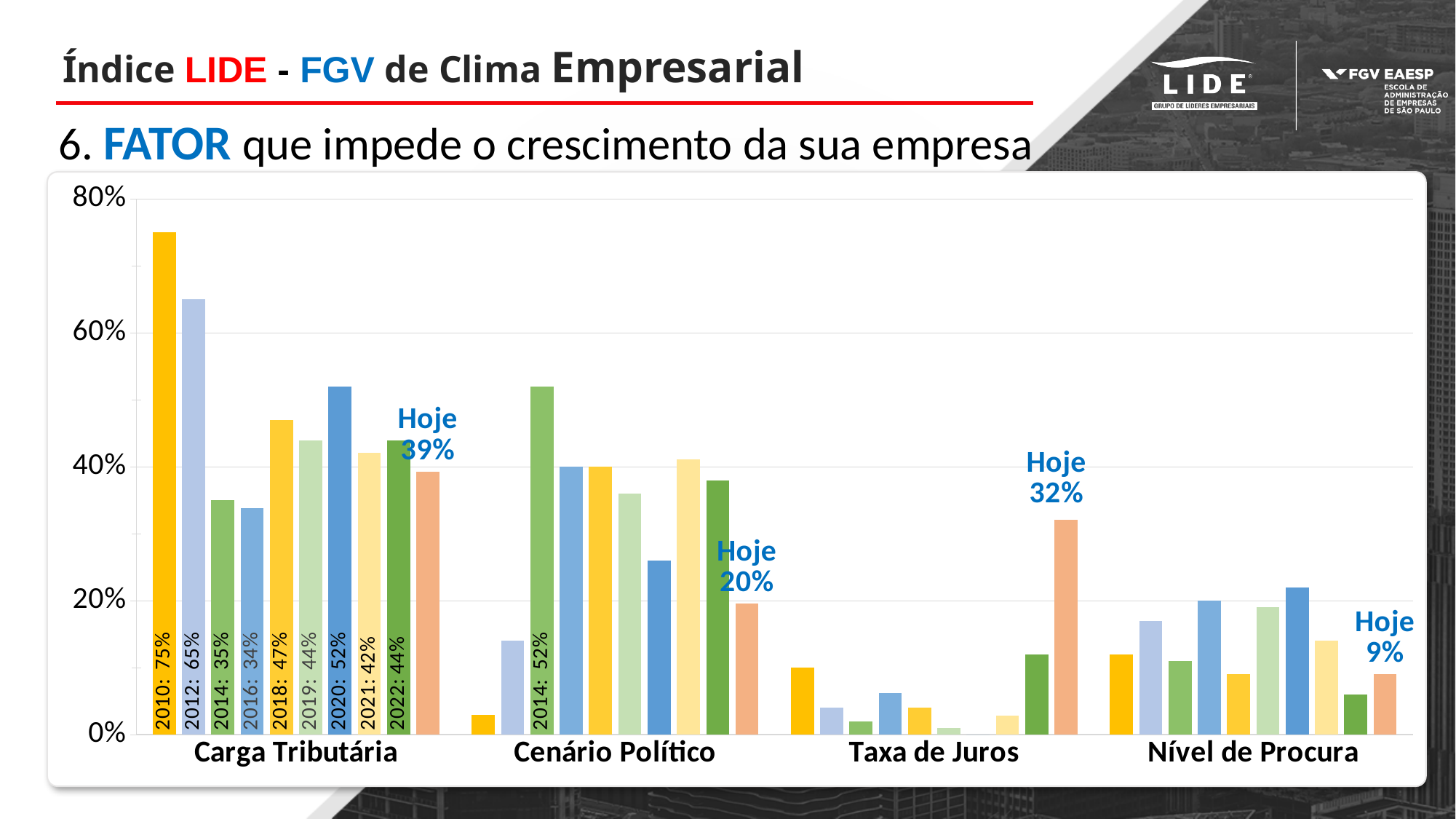
What is the value for Cenário Político in 2014? 52% Which is larger: the 'Hoje' value for Carga Tributária or the 'Hoje' value for Taxa de Juros? Carga Tributária Is the value of the first (2010) bar in the Taxa de Juros group greater or less than 20%? less How many categories are shown on the x axis? 4 What is the 'Hoje' value for Cenário Político? 20% What is the 'Hoje' value for Taxa de Juros? 32% Among the 'Hoje' values, which category is the lowest? Nível de Procura What is the difference between the Carga Tributária values for 2020 and 2021? 10 percentage points Within the Carga Tributária group, which year has the highest value? 2010 What is the difference between the Carga Tributária values for 2010 and 2012? 10 percentage points What is the value for Carga Tributária in 2010? 75% What is the 'Hoje' value for Nível de Procura? 9%